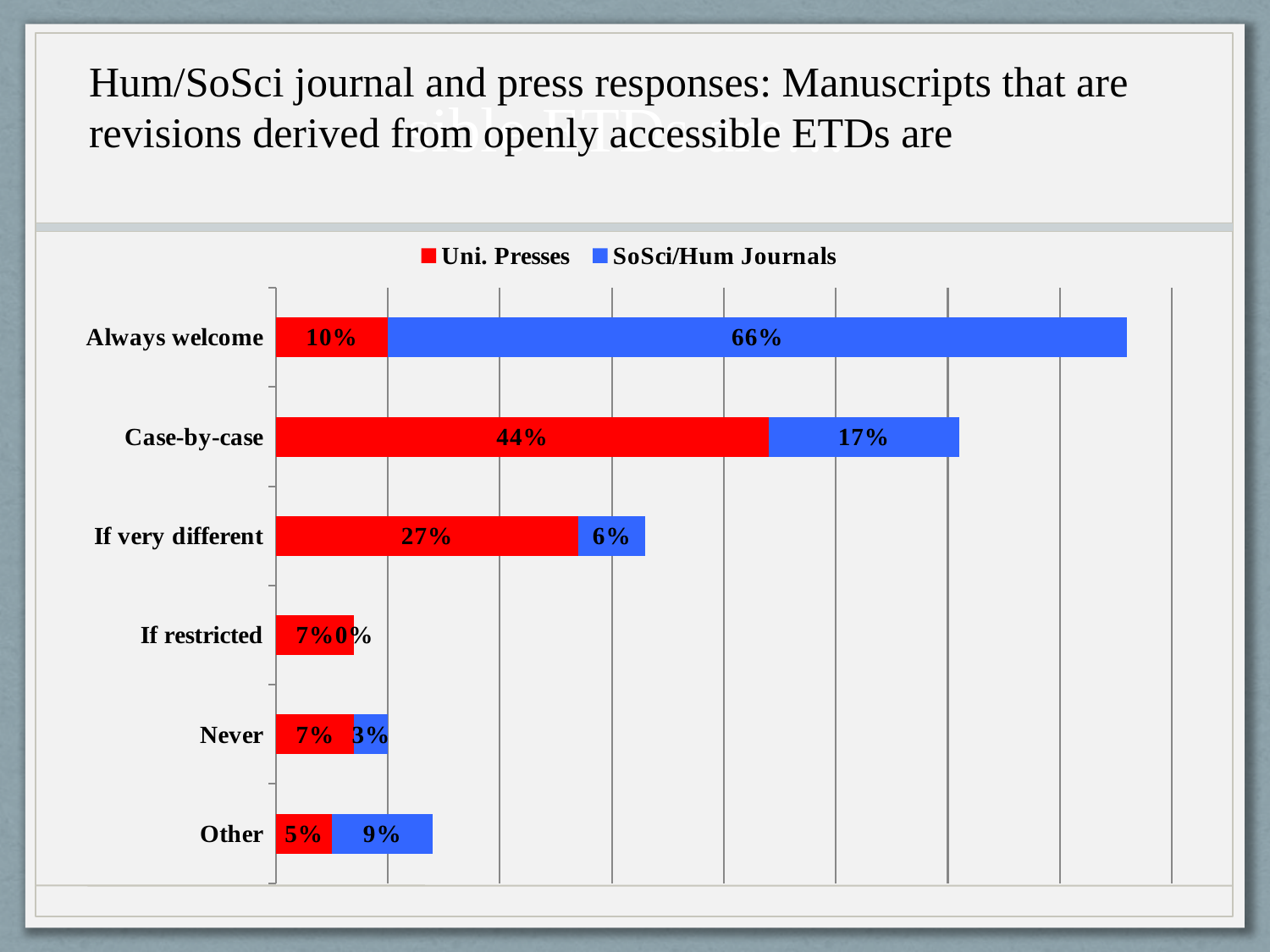
What is the SoSci/Hum Journals value for Always welcome? 66% For Other, which series has the larger value, Uni. Presses or SoSci/Hum Journals? SoSci/Hum Journals What is the Uni. Presses value for Case-by-case? 44% What is the difference between the SoSci/Hum Journals and Uni. Presses values for Always welcome? 56% How many series does the legend list? 2 What is the Uni. Presses value for Other? 5% Which category has the highest SoSci/Hum Journals value? Always welcome Which category has the lowest SoSci/Hum Journals value? If restricted What is the SoSci/Hum Journals value for If very different? 6% What is the total of the stacked bar for Case-by-case? 61% How many categories are shown on the chart? 6 Which category has the highest Uni. Presses value? Case-by-case